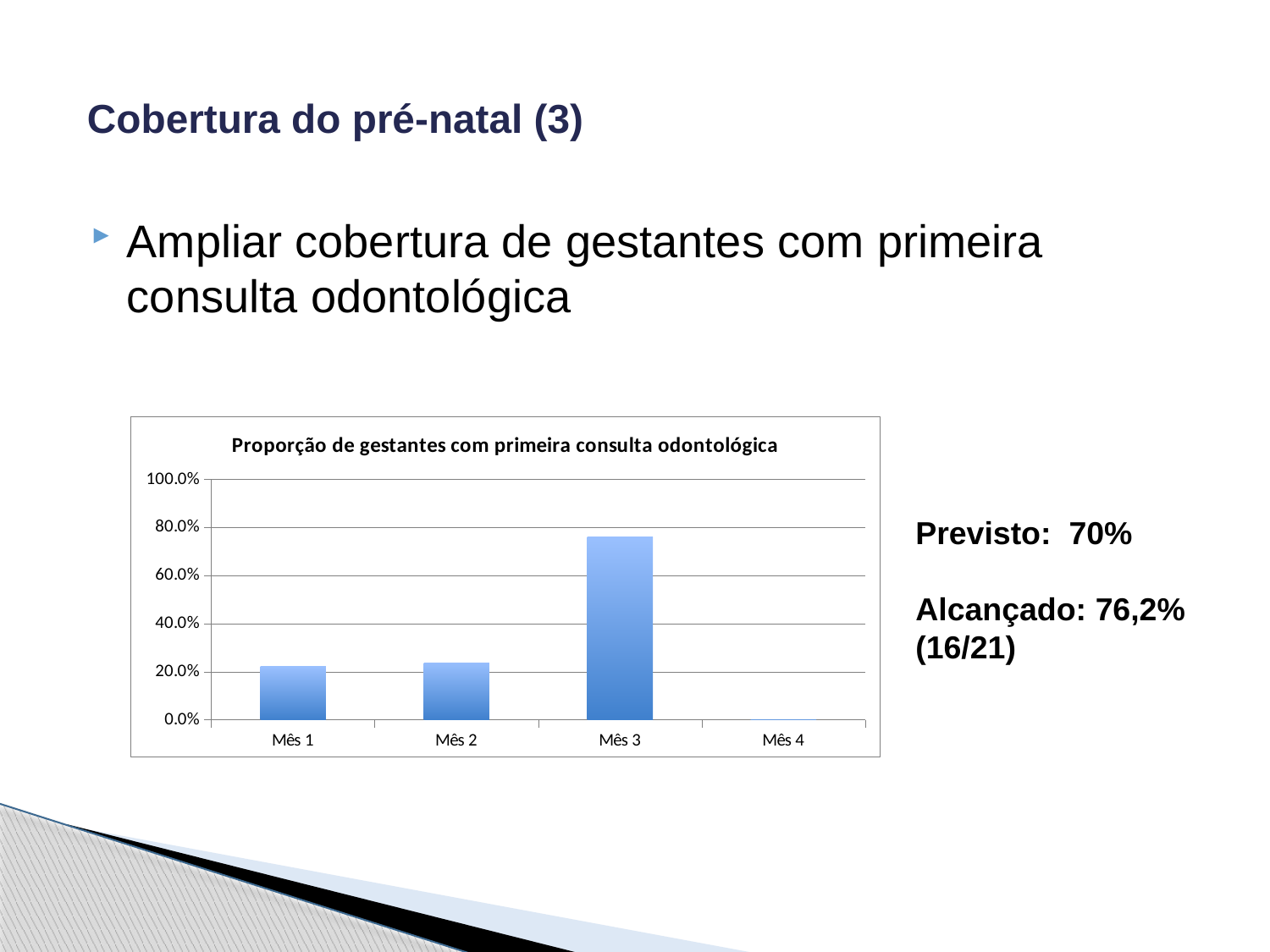
Which month has the highest proportion of pregnant women with a first dental consultation? Mês 3 Is the value for Mês 1 greater or less than 40.0%? less Which is larger, the value for Mês 3 or the value for Mês 1? Mês 3 Is the value for Mês 3 greater or less than 80.0%? less Which month has the lowest value in the chart? Mês 4 Is the value for Mês 4 greater or less than 20.0%? less What kind of chart is shown on the slide? bar chart What is the highest value shown on the chart's y axis? 100.0% What is the title of the chart? Proporção de gestantes com primeira consulta odontológica How many categories are plotted on the x axis of the chart? 4